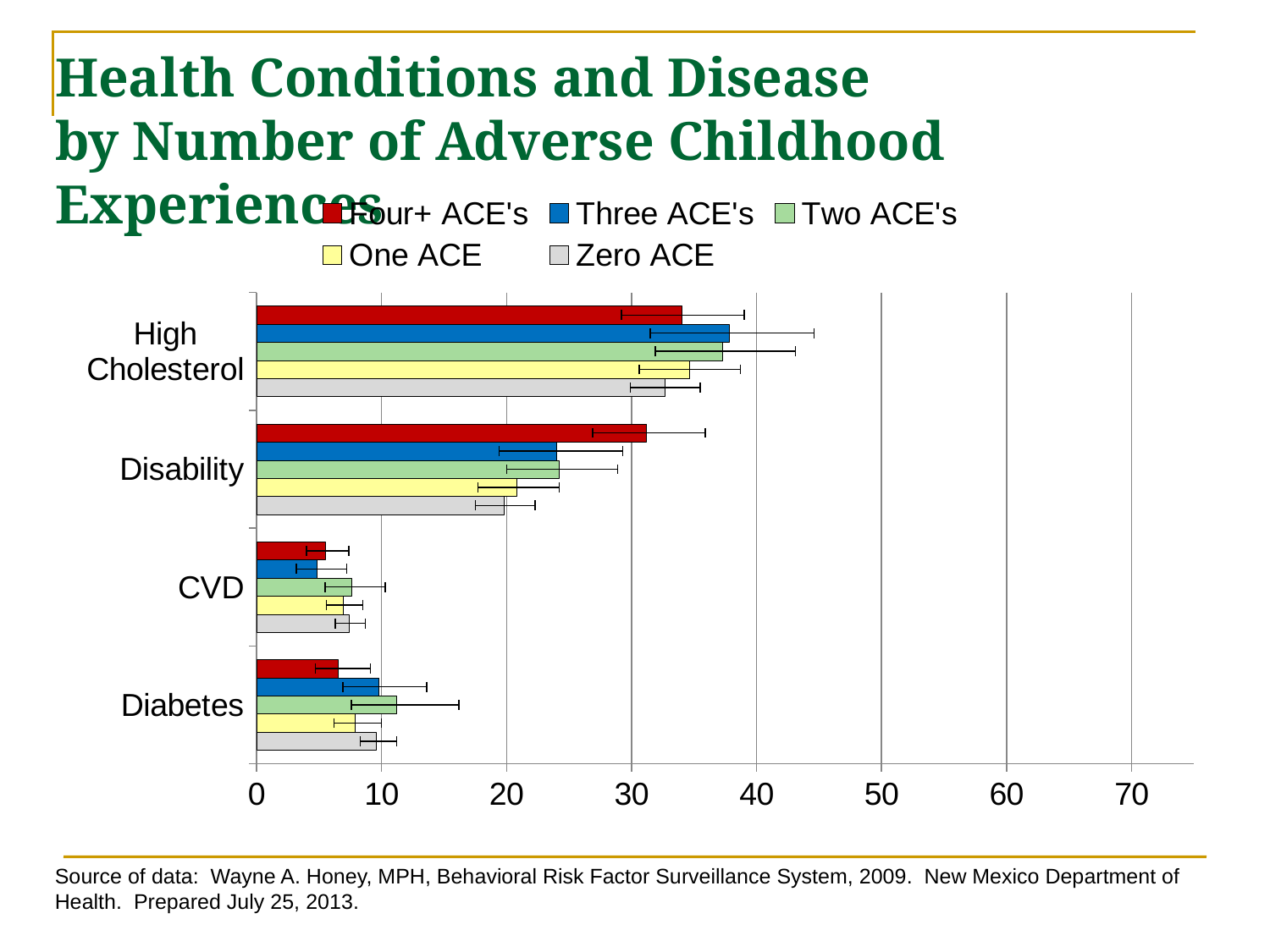
Is the value for Three ACE's in the High Cholesterol category greater or less than 30? greater Is the value for Four+ ACE's in the Disability category greater or less than 20? greater For the Four+ ACE's series, which is larger: High Cholesterol or Disability? High Cholesterol How many series does the chart's legend list? 5 What colour represents the Four+ ACE's series in the chart? Red Is the value for Two ACE's in the Diabetes category greater or less than 20? less In the Disability category, which is larger: the Four+ ACE's bar or the Zero ACE bar? Four+ ACE's What kind of chart is shown on the slide? Bar chart How many health conditions are listed on the vertical axis of the chart? 4 Which health condition has the highest value for the Four+ ACE's series? High Cholesterol